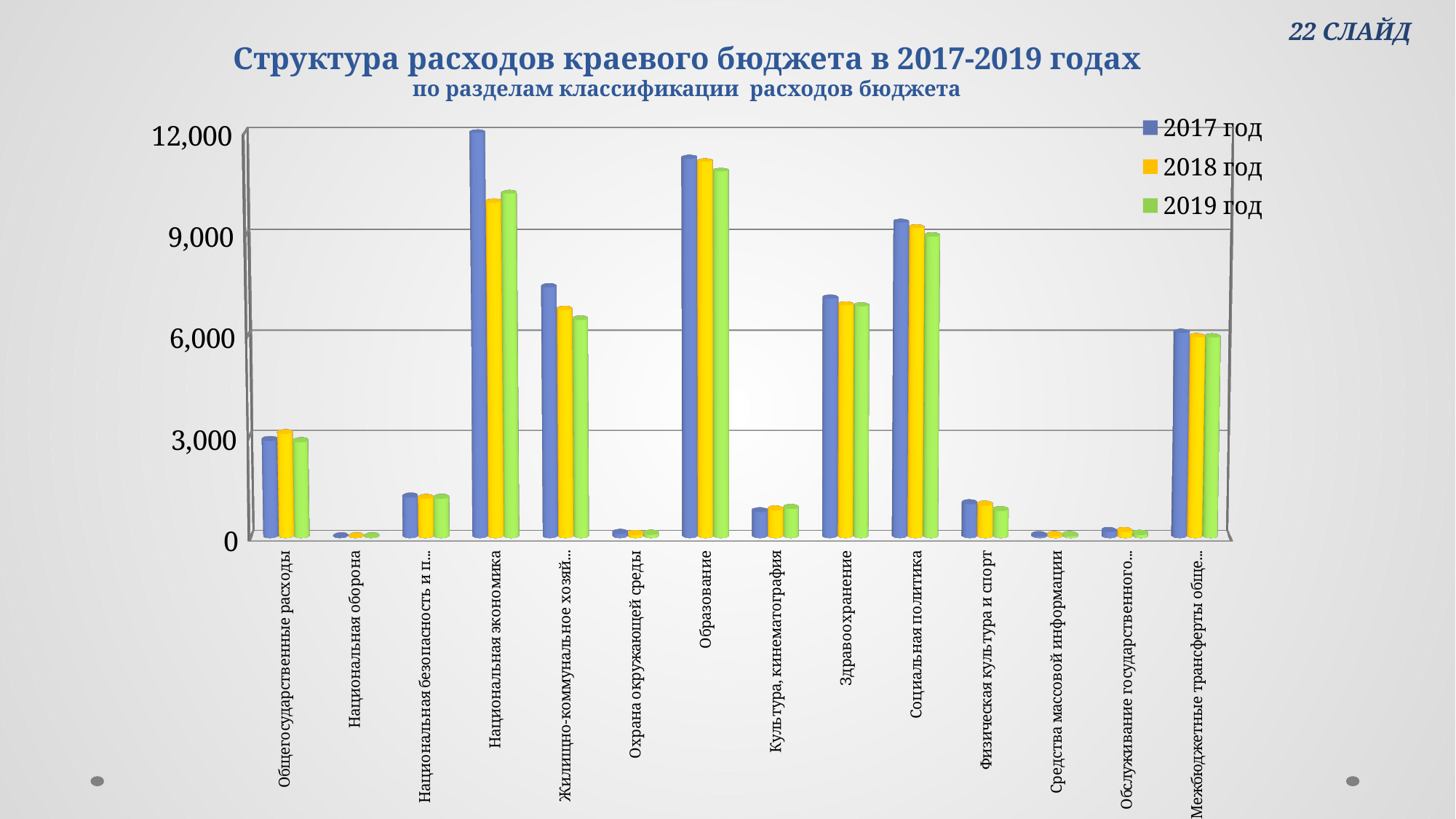
Which category has the highest value for 2017 год? Национальная экономика What are the three legend entries of the chart? 2017 год, 2018 год, 2019 год Is the value for Жилищно-коммунальное хозяйство in 2019 год greater or less than 9,000? less How many categories are shown along the x axis? 14 How many series does the legend list? 3 Is the value for Социальная политика in 2019 год greater or less than 6,000? greater Do the values for Национальная экономика rise or fall from 2017 год to 2019 год? fall Is the value for Образование in 2017 год greater or less than 9,000? greater Which is larger for 2019 год: Образование or Национальная экономика? Образование Which is larger for 2017 год: Национальная экономика or Образование? Национальная экономика What kind of chart is shown on the slide? Bar chart